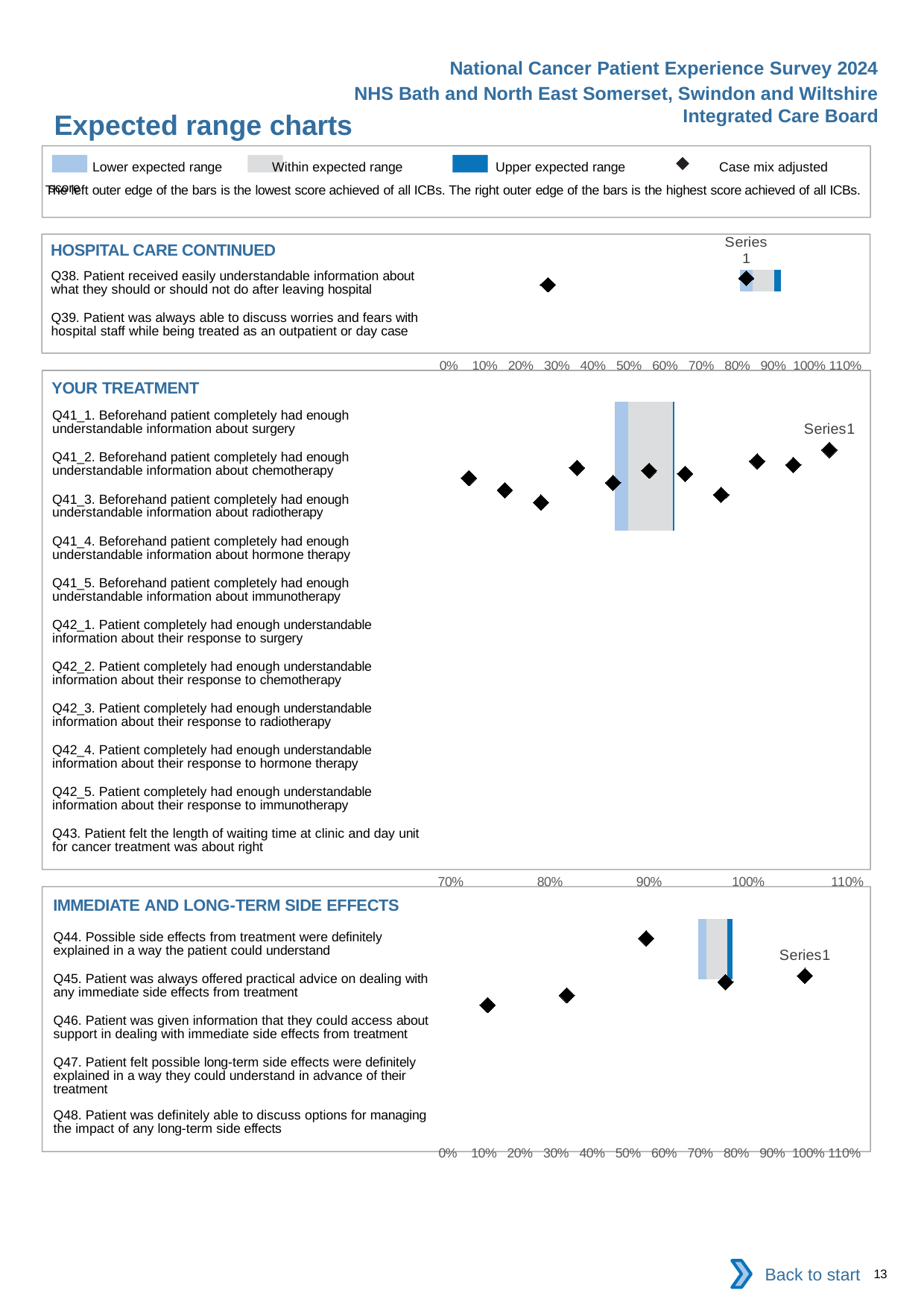
What is the highest tick label on the x axis of the 'YOUR TREATMENT' chart? 110% What is the lowest tick label on the x axis of the 'IMMEDIATE AND LONG-TERM SIDE EFFECTS' chart? 0% How many diamond markers are plotted in the 'YOUR TREATMENT' chart? 11 How many questions are listed in the 'IMMEDIATE AND LONG-TERM SIDE EFFECTS' chart? 5 How many questions are listed in the 'HOSPITAL CARE CONTINUED' chart? 2 In the legend at the top of the slide, what does the diamond marker represent? Case mix adjusted score How many entries does the legend at the top of the slide list? 4 What is the lowest tick label on the x axis of the 'YOUR TREATMENT' chart? 70%